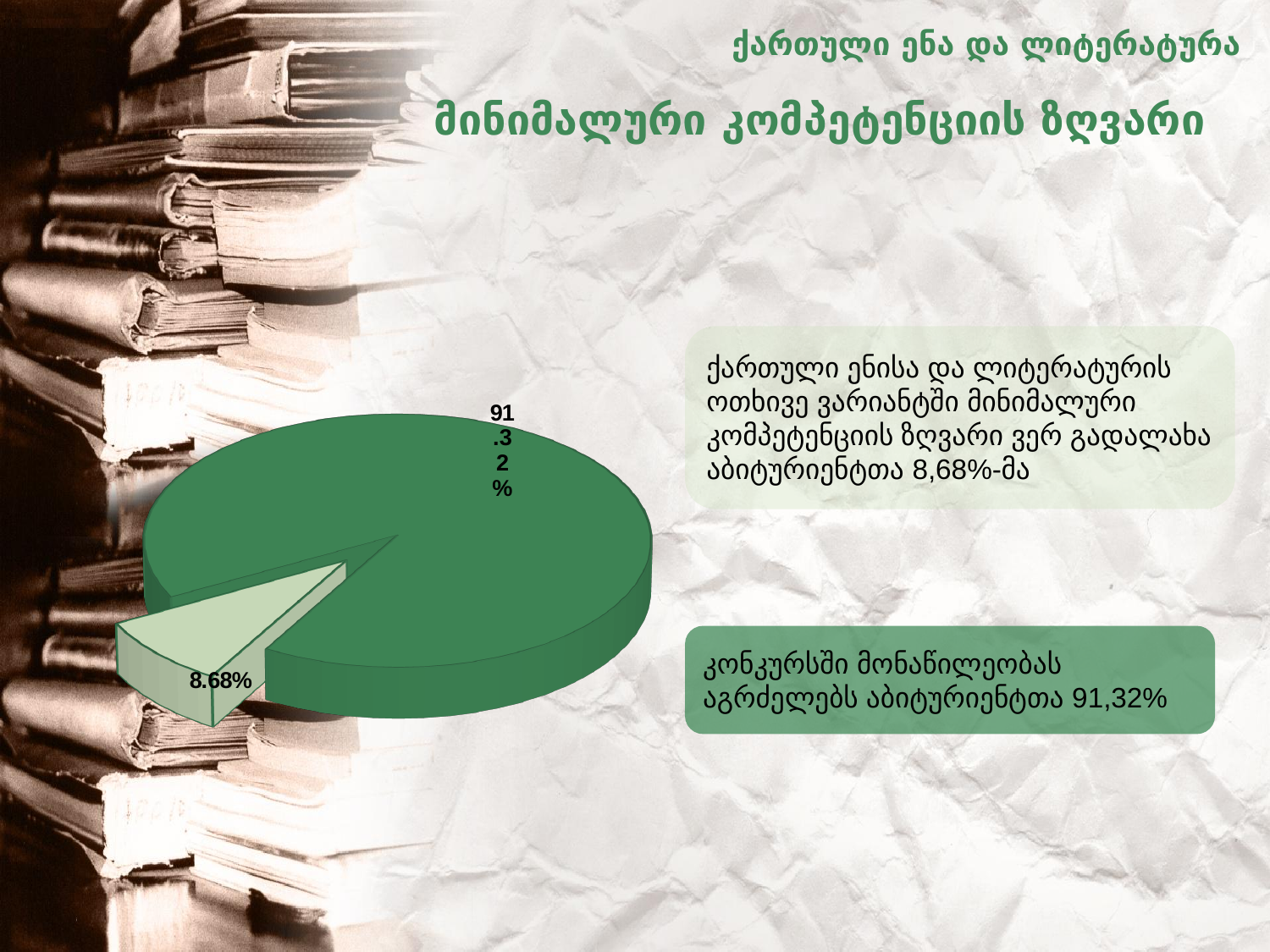
What colour is the slice that is pulled out from the rest of the pie? light green What is the difference between the two slice values in the pie chart? 82.64% How many slices does the pie chart have? 2 What value is labelled on the small light green slice that is pulled out from the pie chart? 8.68% Which slice is larger, the dark green one or the light green one? the dark green one What kind of chart is shown on the slide? pie chart What share of the pie does the exploded (pulled-out) slice represent? 8.68% Does the pie chart have a legend? No What do the two slice values in the pie chart add up to? 100% What is the value of the smallest slice in the pie chart? 8.68% What value is labelled on the large dark green slice of the pie chart? 91.32% What is the value of the largest slice in the pie chart? 91.32%